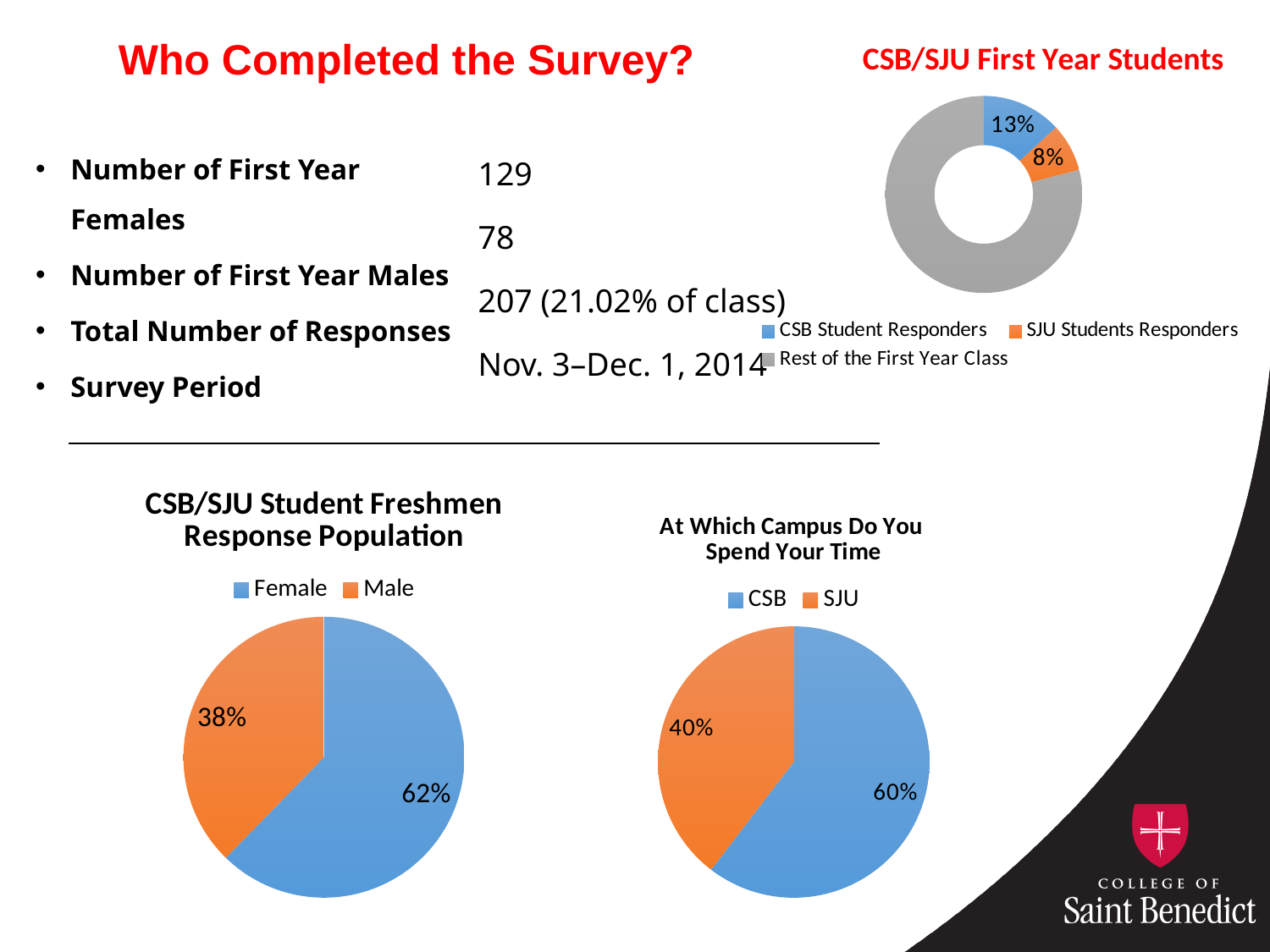
In the 'CSB/SJU Student Freshmen Response Population' chart, what share of the pie is Female? 62% In the 'CSB/SJU Student Freshmen Response Population' chart, which category is larger, Female or Male? Female In the 'CSB/SJU Student Freshmen Response Population' chart, what share of the pie is Male? 38% In the 'CSB/SJU First Year Students' chart, what percentage is labelled for SJU Students Responders? 8% In the 'CSB/SJU First Year Students' chart, how many entries does the legend list? 3 What kind of chart is 'At Which Campus Do You Spend Your Time'? Pie chart In the 'CSB/SJU First Year Students' chart, what is the difference between the CSB Student Responders and SJU Students Responders percentages? 5% In the 'At Which Campus Do You Spend Your Time' chart, what percentage is labelled for SJU? 40% In the 'At Which Campus Do You Spend Your Time' chart, what is the difference between the CSB and SJU percentages? 20% In the 'CSB/SJU First Year Students' chart, what percentage is labelled for CSB Student Responders? 13% In the 'CSB/SJU First Year Students' chart, which slice is the largest? Rest of the First Year Class In the 'At Which Campus Do You Spend Your Time' chart, how many categories does the legend list? 2